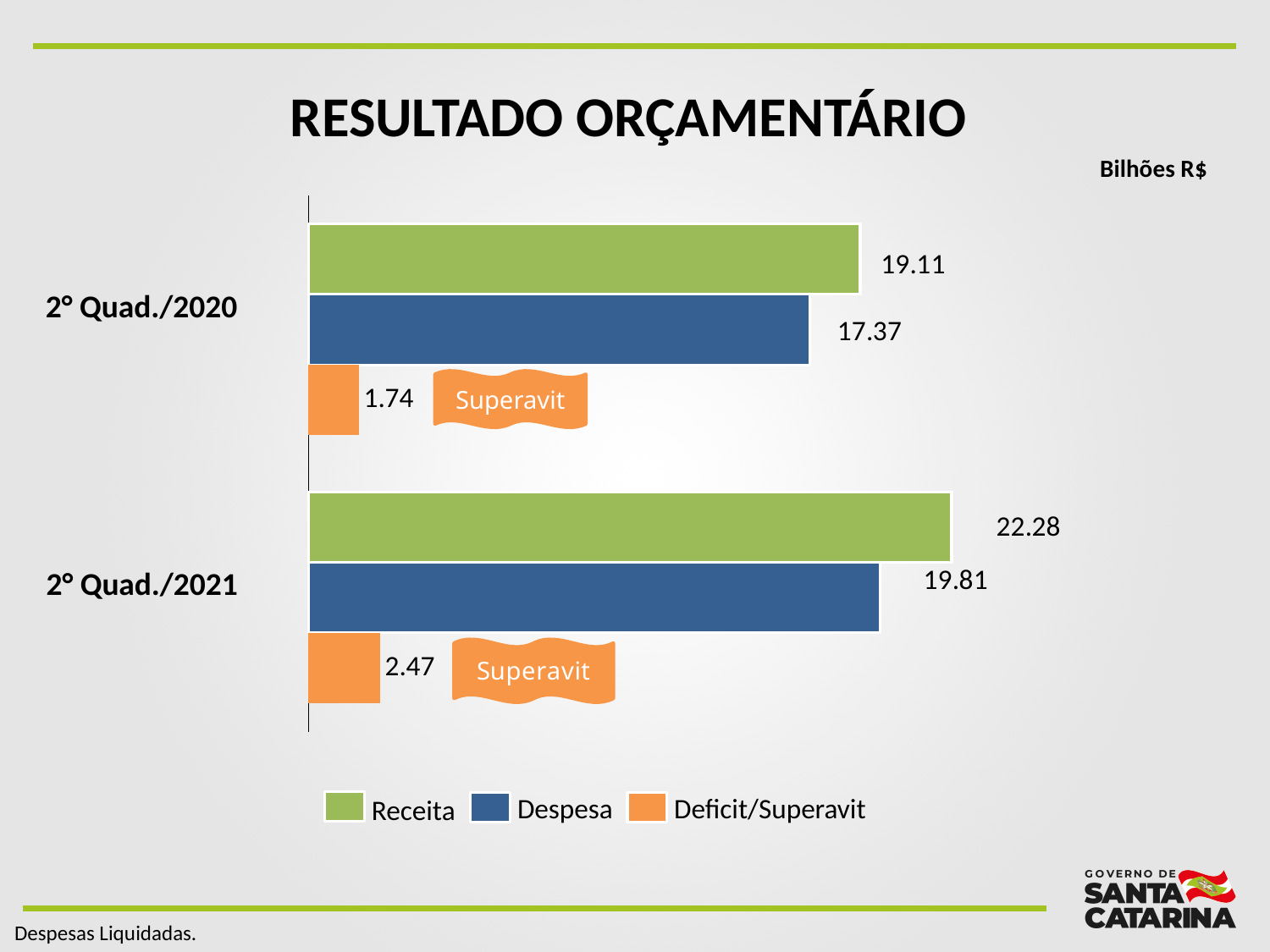
How many series does the legend list? 3 What is the difference between Receita and Despesa for 2° Quad./2020? 1.74 What is the Despesa value for 2° Quad./2021? 19.81 What is the Deficit/Superavit value for 2° Quad./2020? 1.74 What kind of chart is shown on the slide? bar chart What is the Receita value for 2° Quad./2021? 22.28 Which period has the lower Deficit/Superavit value? 2° Quad./2020 What unit is indicated for the values in the chart? Bilhões R$ What is the difference in Despesa between 2° Quad./2021 and 2° Quad./2020? 2.44 Is the Despesa value for 2° Quad./2021 larger or smaller than the Receita value for 2° Quad./2020? larger Which period has the higher Receita value? 2° Quad./2021 What is the Receita value for 2° Quad./2020? 19.11